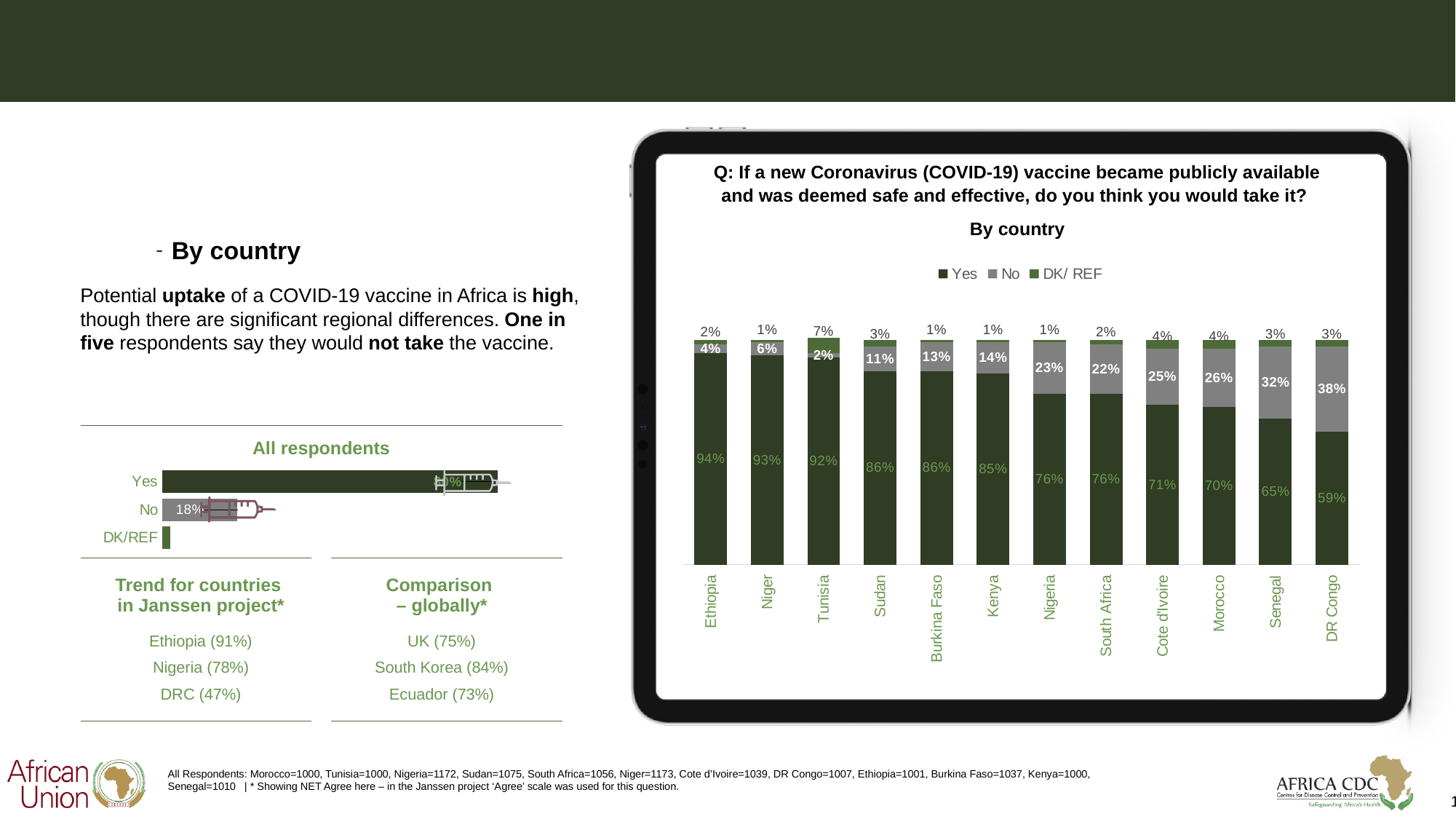
In the 'All respondents' chart on the left, what is the value for No? 18% In the 'By country' chart, what is the difference between the Yes value for Ethiopia and the Yes value for DR Congo? 35 percentage points In the 'By country' chart, what percentage of respondents in Ethiopia said Yes? 94% In the 'By country' chart, what is the DK/ REF value for Tunisia? 7% How many countries are shown in the 'By country' chart? 12 In the 'By country' chart, which country has the larger No value, Senegal or Morocco? Senegal In the 'By country' chart, what percentage of respondents in DR Congo said No? 38% In the 'By country' chart, which country has the highest Yes value? Ethiopia In the 'By country' chart, do the Yes values rise or fall from left to right along the x axis? Fall How many series does the legend of the 'By country' chart list? 3 In the 'By country' chart, which country has the lowest Yes value? DR Congo What kind of chart is the 'By country' chart? Stacked bar chart